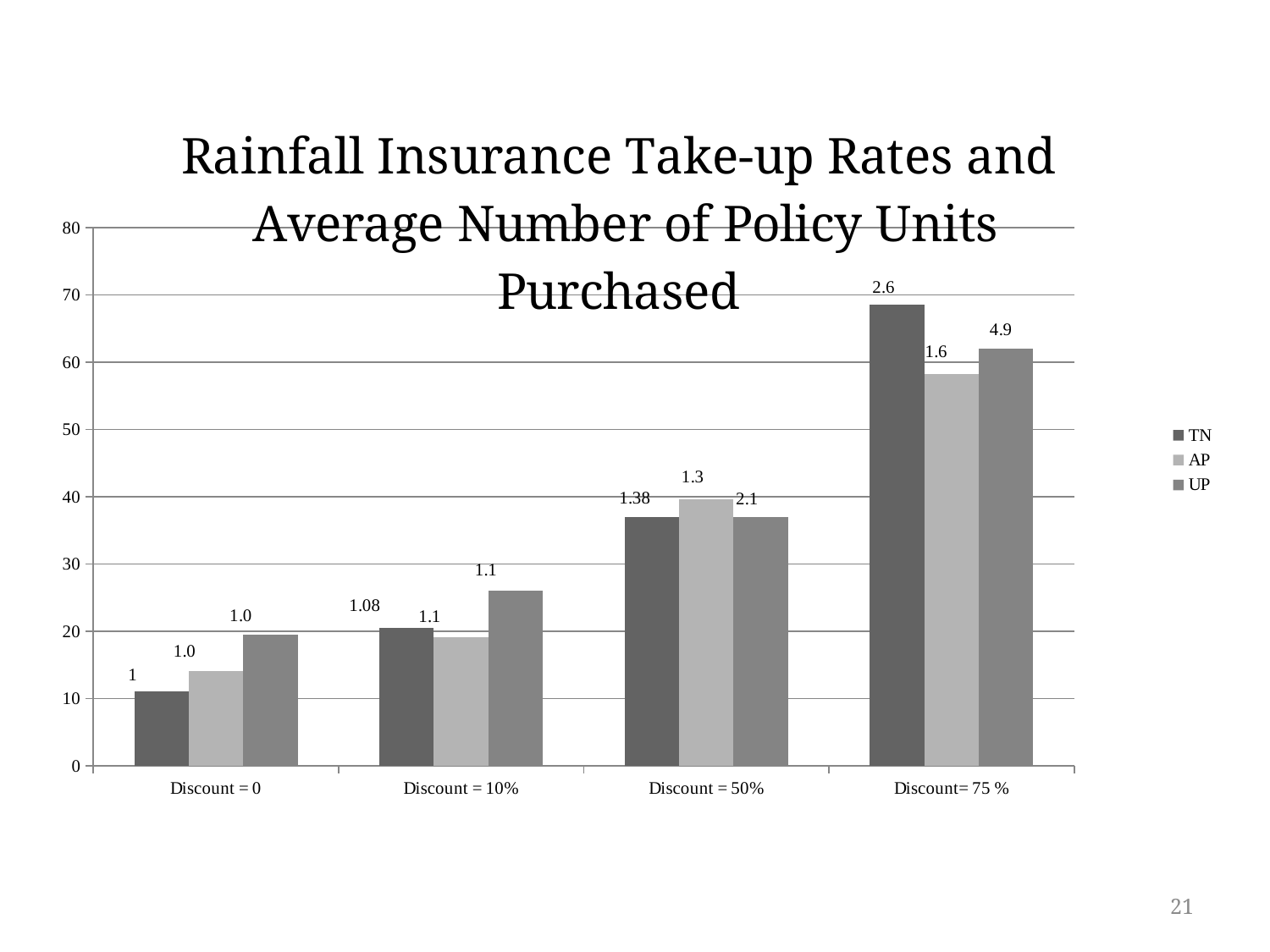
How many series does the legend list? 3 Is the UP bar for Discount = 10% greater or less than 20? greater Is the TN bar for Discount = 0 greater or less than 20? less Do the bar heights generally rise or fall as the discount increases along the x axis? rise What data label is printed above the TN bar for Discount = 50%? 1.38 How many discount categories are shown on the x axis? 4 Which discount category has the tallest bars? Discount= 75 % Which series has the tallest bar in the Discount= 75 % category? TN What kind of chart is shown on the slide? bar chart Which series has the shortest bar in the Discount = 0 category? TN What data label is printed above the UP bar for Discount= 75 %? 4.9 What data label is printed above the AP bar for Discount= 75 %? 1.6